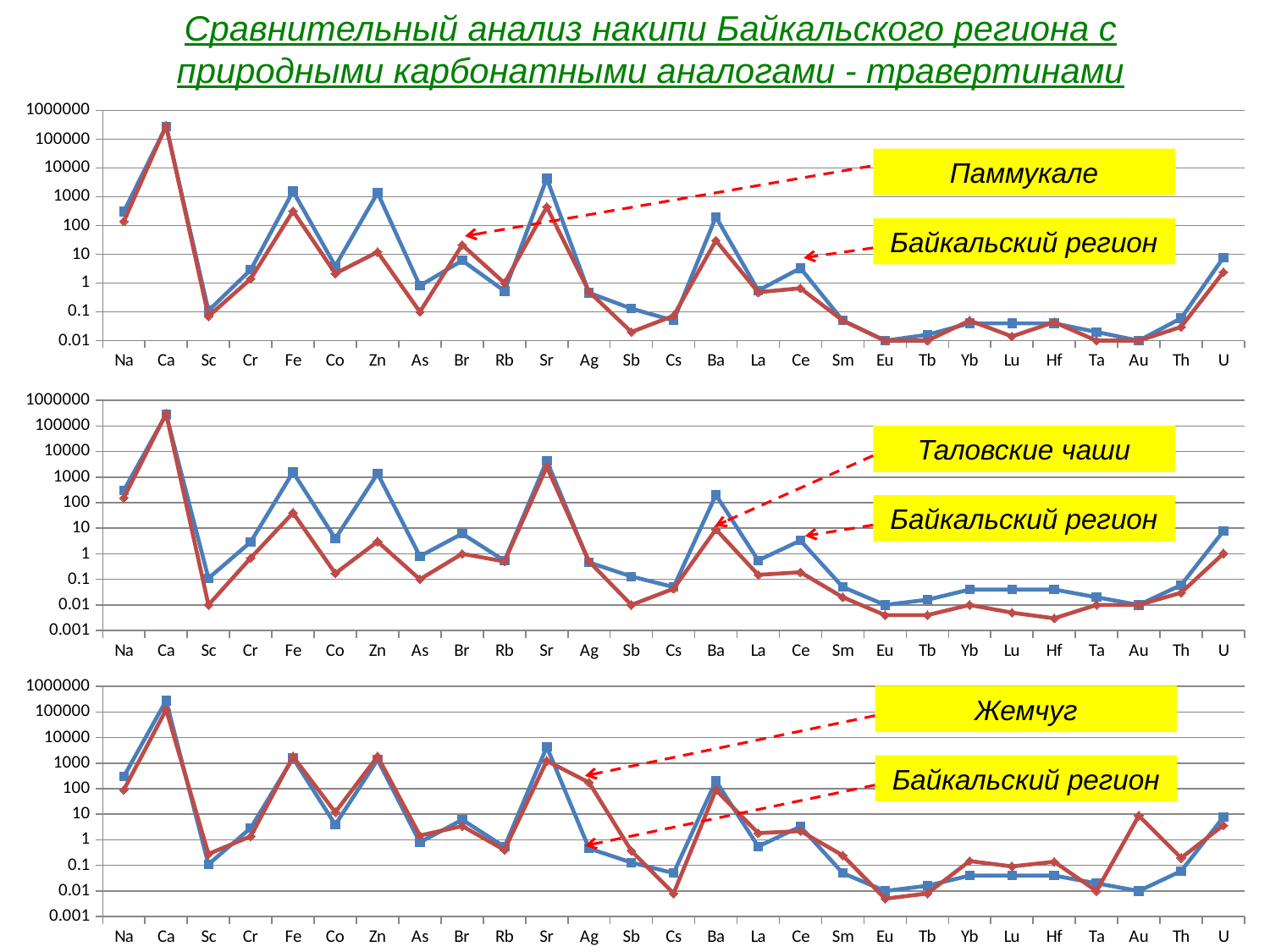
In the bottom chart, is the value for Au in the Жемчуг series greater or less than 1? greater In the middle chart, is the value for Hf in the Таловские чаши series greater or less than 0.01? less In the bottom chart, which element has the highest value for the Жемчуг series? Ca In the top chart, which series has the higher value at Zn, Паммукале or Байкальский регион? Байкальский регион What kind of chart is the top chart on the slide? line chart In the bottom chart, which series has the higher value at Au, Жемчуг or Байкальский регион? Жемчуг How many categories (elements) are shown on the x axis of the top chart? 27 In the middle chart, which series has the higher value at Fe, Таловские чаши or Байкальский регион? Байкальский регион What is the lowest tick value shown on the y axis of the bottom chart? 0.001 In the top chart, is the value for Fe in the Байкальский регион series greater or less than 1000? greater In the top chart, which element has the highest value for the Байкальский регион series? Ca How many series are plotted in the middle chart? 2